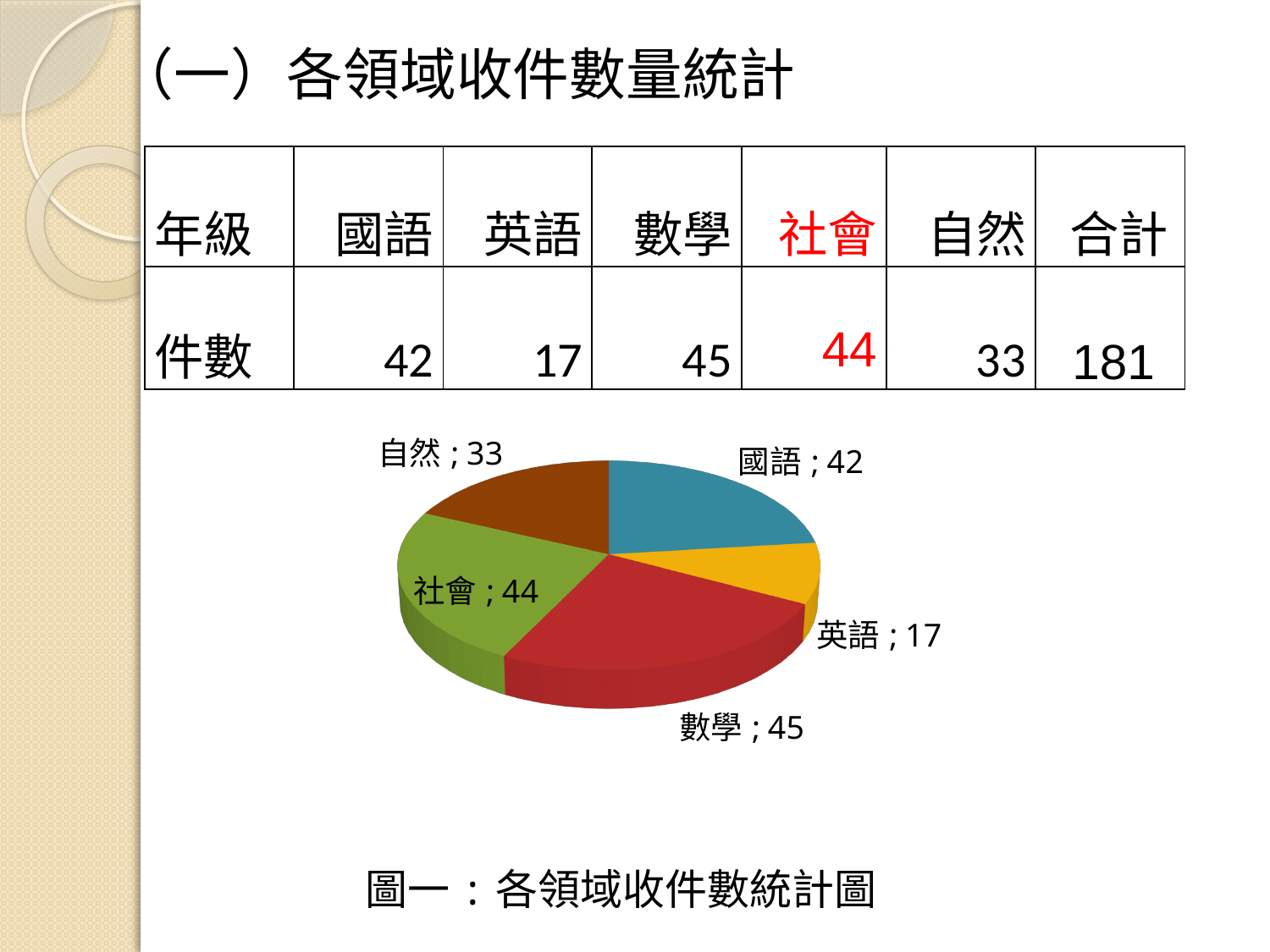
What is the total of all slices in the pie chart? 181 Which is larger in the pie chart, 國語 or 自然? 國語 What is the caption shown below the pie chart? 圖一：各領域收件數統計圖 What kind of chart is shown on the slide? pie chart What is the value for 英語 in the pie chart? 17 Which category has the smallest slice in the pie chart? 英語 What is the value for 數學 in the pie chart? 45 What is the value for 自然 in the pie chart? 33 How many slices does the pie chart have? 5 What is the difference between the values for 國語 and 英語 in the pie chart? 25 What is the value for 社會 in the pie chart? 44 Which category has the largest slice in the pie chart? 數學